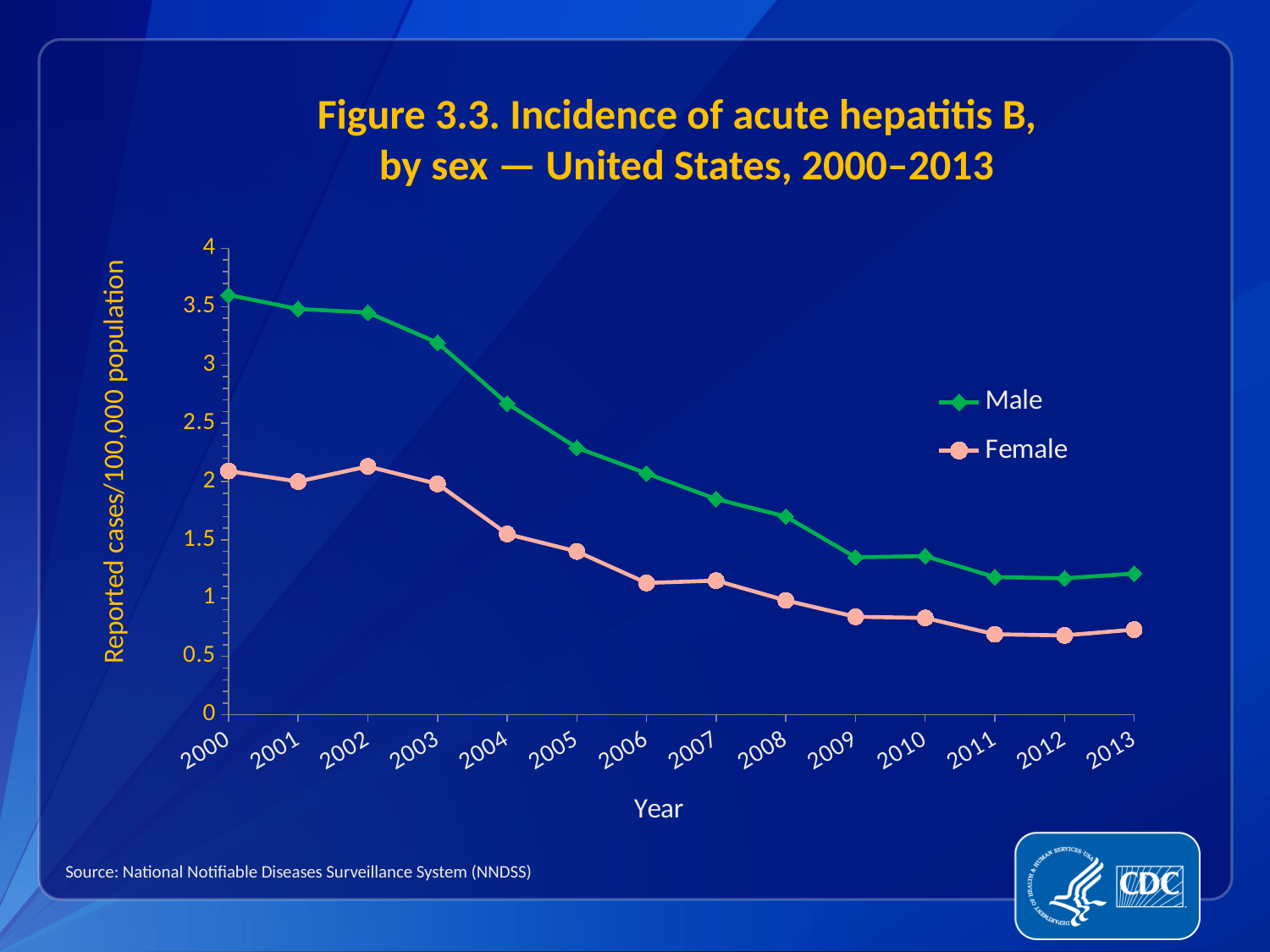
How many series does the legend list? 2 In 2005, which series has the larger value, Male or Female? Male Is the Male value for 2005 greater or less than 2? greater What is the label of the y axis? Reported cases/100,000 population In which year is the Male incidence highest? 2000 Is the Female value for 2013 greater or less than 1? less Do the Male values generally rise or fall from 2000 to 2013? fall Is the Male value for 2000 greater or less than 3? greater How many years are plotted along the x axis? 14 What kind of chart is shown on the slide? line chart